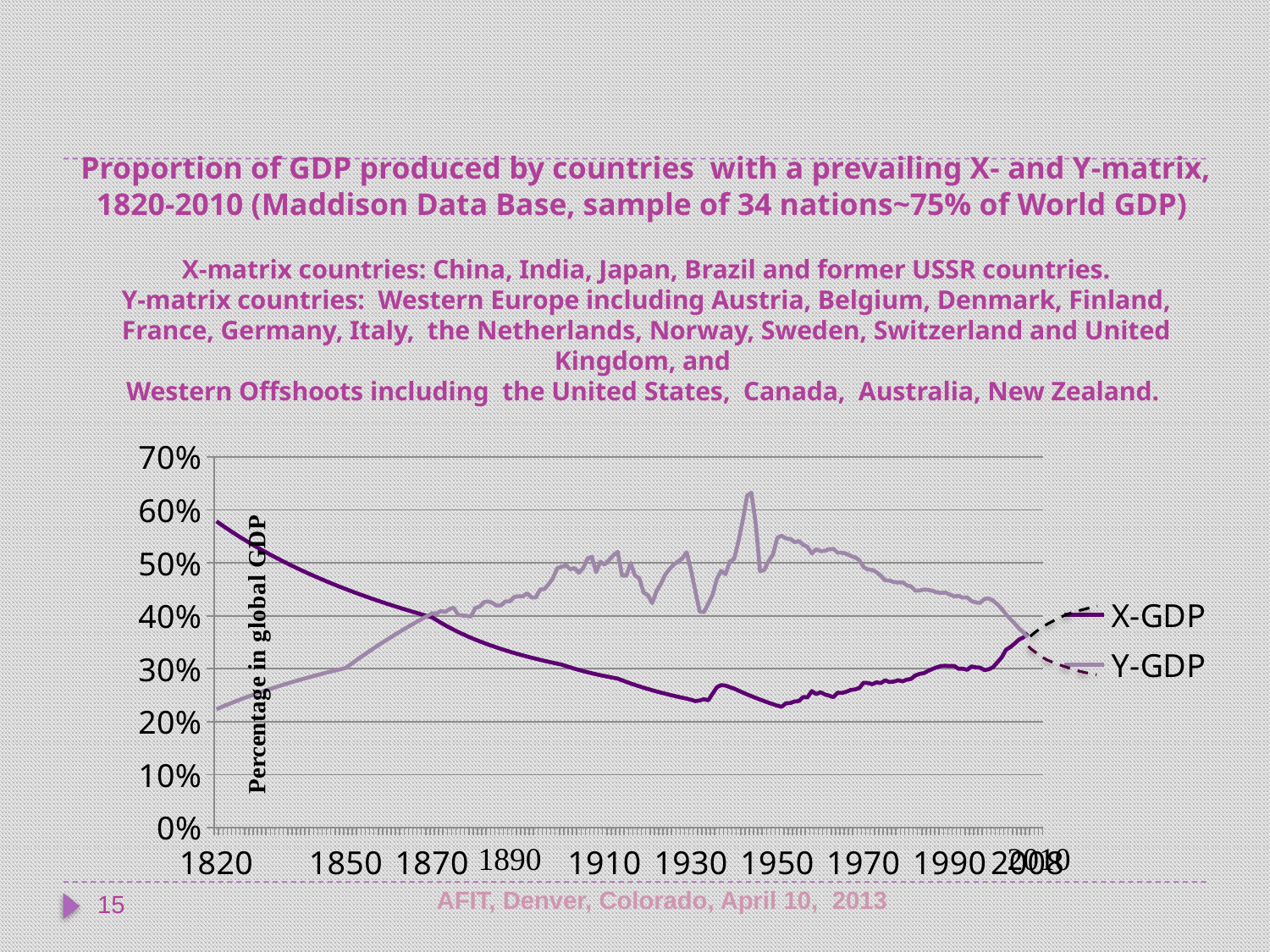
Does the X-GDP line rise or fall between 1820 and 1950? fall Does the Y-GDP line rise or fall between 1820 and 1910? rise Is the value for Y-GDP in 1970 greater or less than 40%? greater Is the value for X-GDP in 1820 greater or less than 50%? greater What kind of chart is shown on the slide? line chart In 1820, which series has the higher value, X-GDP or Y-GDP? X-GDP What are the two series named in the chart's legend? X-GDP and Y-GDP Is the value for X-GDP in 1950 greater or less than 30%? less How many series does the chart's legend list? 2 In 1950, which series has the higher value, X-GDP or Y-GDP? Y-GDP What is the label on the chart's vertical axis? Percentage in global GDP